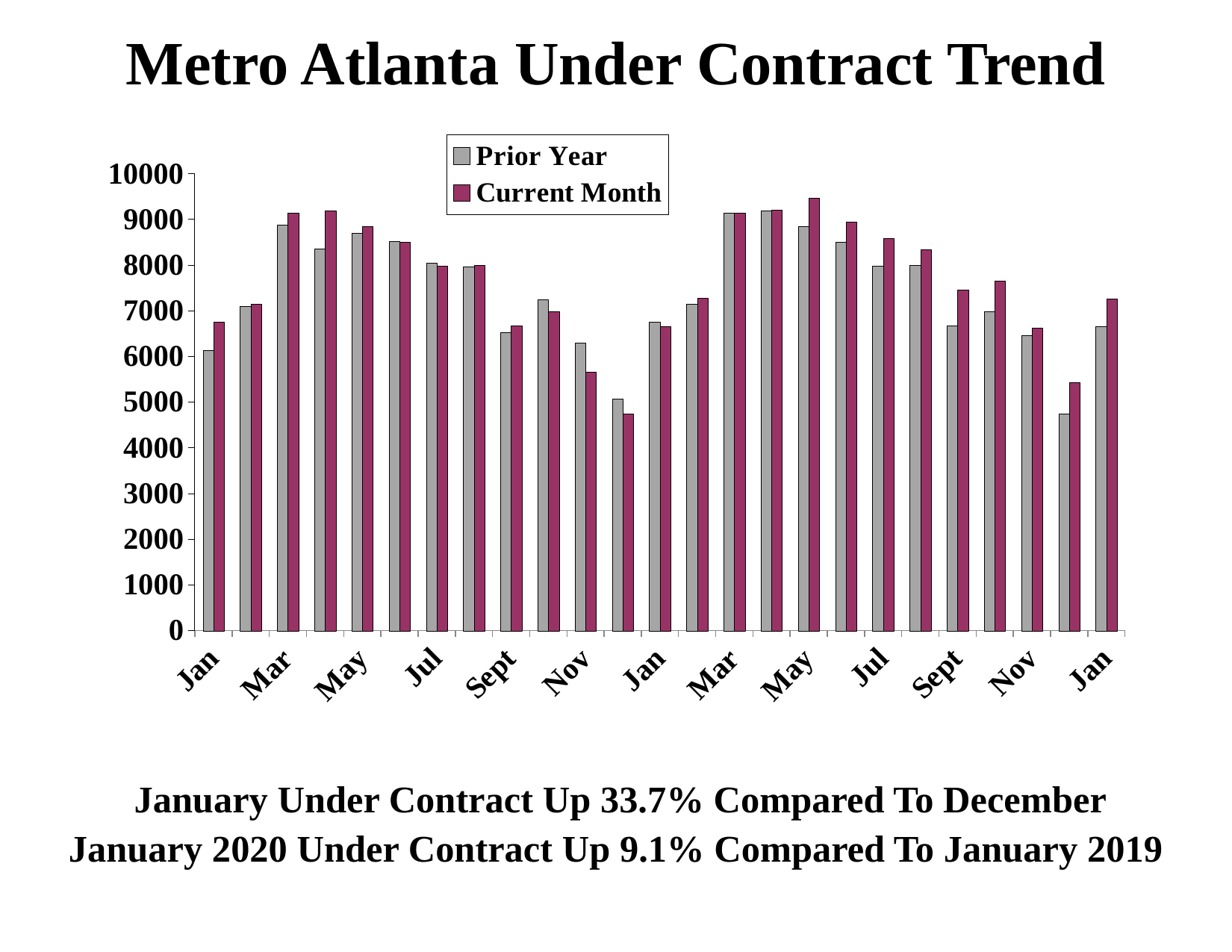
For the first Nov, which series has the larger value, Prior Year or Current Month? Prior Year What are the two series named in the legend? Prior Year and Current Month How many series does the legend list? 2 For the last Jan, which series has the larger value, Prior Year or Current Month? Current Month Is the Current Month value for the second May greater or less than 9000? greater Is the Current Month value for the first Nov greater or less than 6000? less Which labeled month has the highest Current Month value? The second May Is the Current Month value for the first Jan greater or less than 6000? greater Do the Current Month values rise or fall from the second May to the second Nov? Fall What kind of chart is shown on the slide? Bar chart What is the title of the chart? Metro Atlanta Under Contract Trend